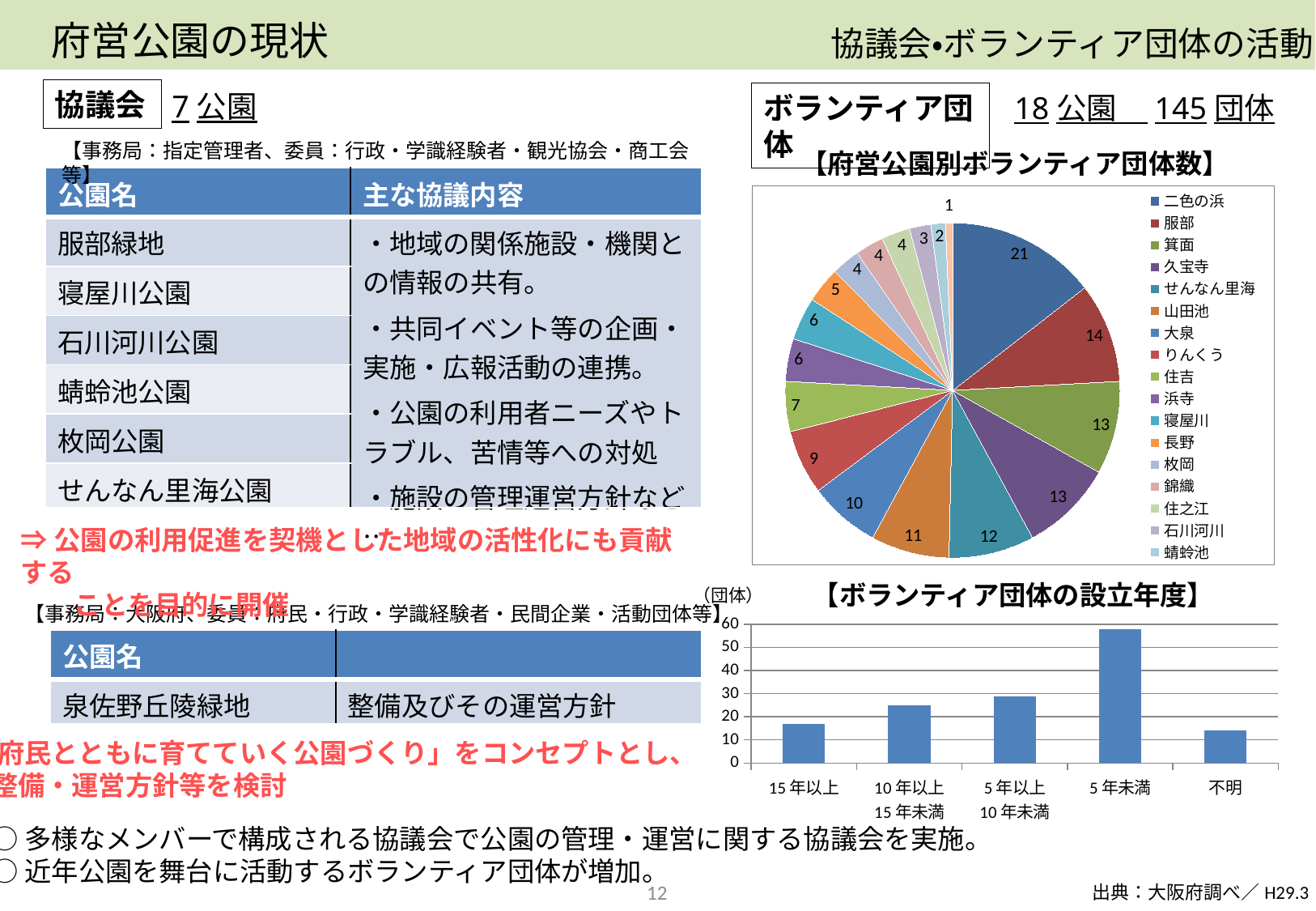
In the 【府営公園別ボランティア団体数】 pie chart, what is the value for 服部? 14 In the 【ボランティア団体の設立年度】 bar chart, is the value for 15年以上 greater or less than 20? less In the 【府営公園別ボランティア団体数】 pie chart, what is the value for 二色の浜? 21 How many categories are shown on the x axis of the 【ボランティア団体の設立年度】 bar chart? 5 In the 【府営公園別ボランティア団体数】 pie chart, what is the difference between the values for 二色の浜 and 服部? 7 In the 【ボランティア団体の設立年度】 bar chart, is the value for 5年未満 greater or less than 50? greater What kind of chart is the 【ボランティア団体の設立年度】 chart? bar chart In the 【ボランティア団体の設立年度】 bar chart, which category has the lowest bar? 不明 In the 【ボランティア団体の設立年度】 bar chart, which category has the highest bar? 5年未満 In the 【府営公園別ボランティア団体数】 pie chart, which park has the largest slice? 二色の浜 What kind of chart is the 【府営公園別ボランティア団体数】 chart? pie chart In the 【ボランティア団体の設立年度】 bar chart, which is larger, 5年未満 or 15年以上? 5年未満